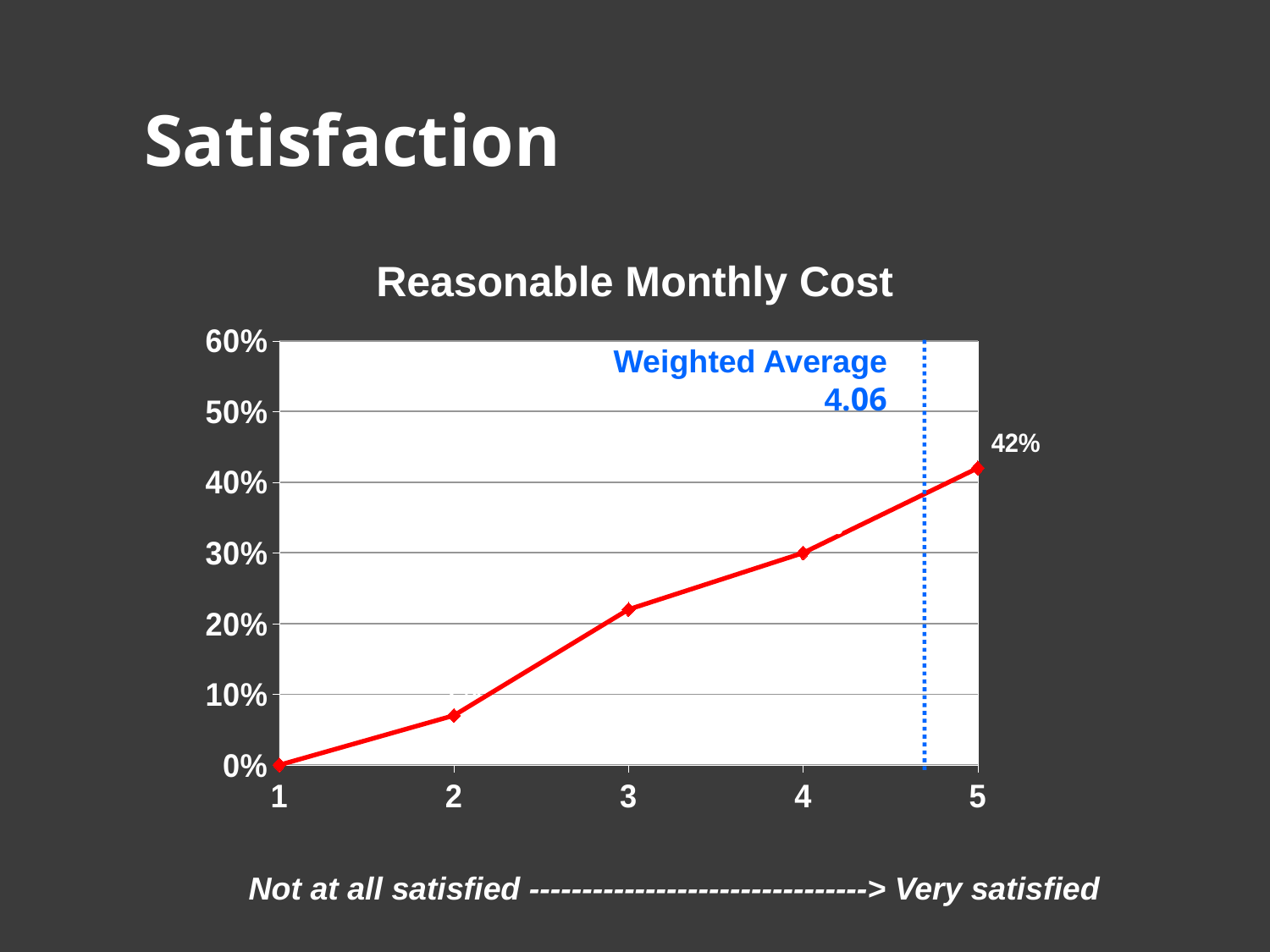
What is the value at rating 5? 42% Do the values rise or fall as the rating increases from 1 to 5? rise Which rating has the highest value? 5 What weighted average is shown on the chart? 4.06 Which is larger, the value for rating 4 or the value for rating 2? rating 4 How many data points are plotted on the line? 5 What is the title of the chart? Reasonable Monthly Cost What is the value at rating 1? 0% Is the value for rating 2 greater or less than 10%? less Is the value for rating 3 greater or less than 30%? less What kind of chart is shown on the slide? line chart Which rating has the lowest value? 1